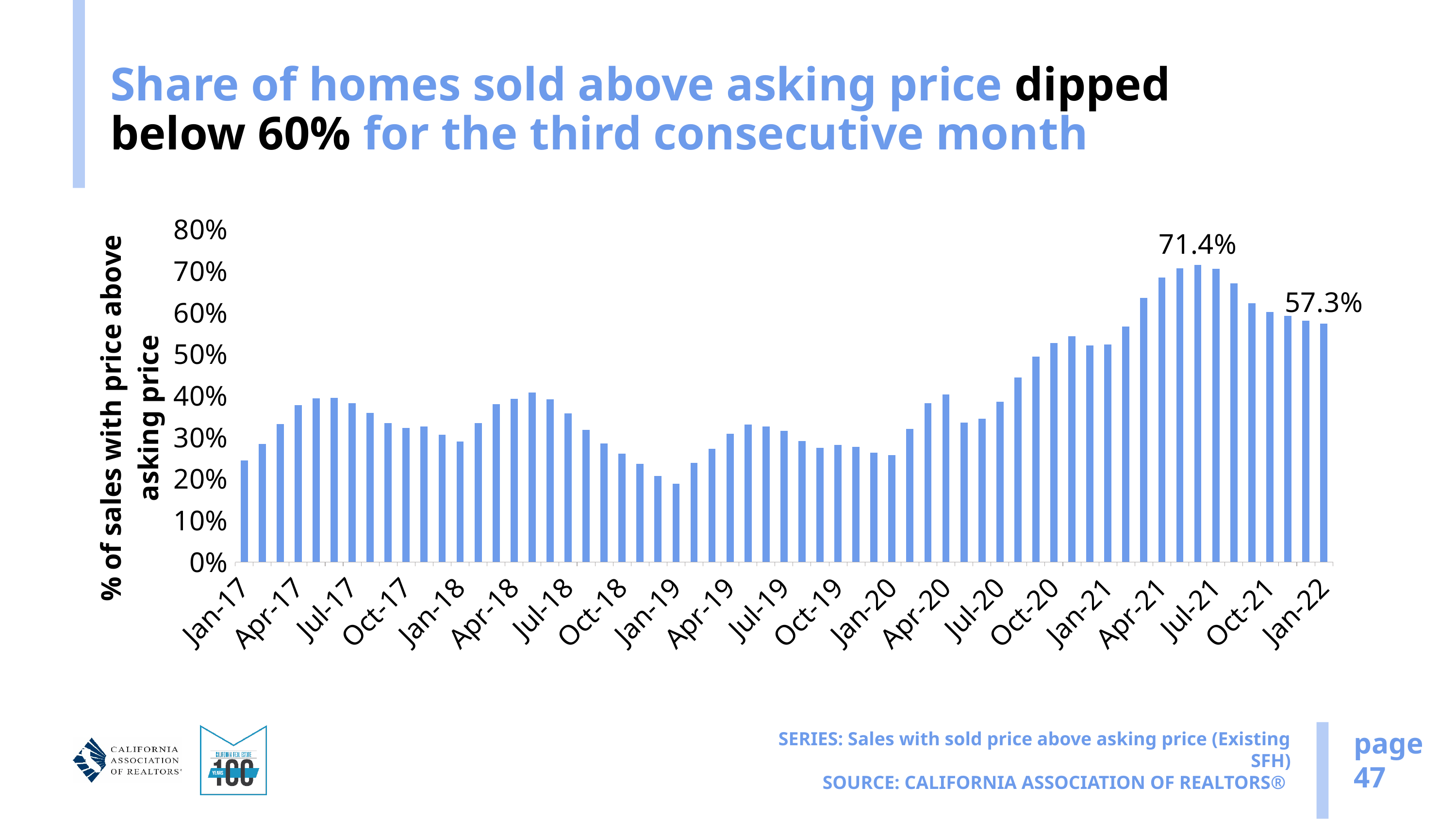
Do the values rise or fall from the 71.4% peak to Jan-22? fall Is the value for Jan-17 greater or less than 30%? less Do the values rise or fall from Jan-20 to the peak in mid-2021? rise What is the title of the vertical axis? % of sales with price above asking price What is the share of sales with price above asking price for Jan-22? 57.3% What type of chart is shown on the slide? Bar chart What is the difference between the peak value of 71.4% and the Jan-22 value of 57.3%? 14.1 percentage points Is the value for Oct-20 greater or less than 50%? greater Which month has the larger value, Jan-17 or Jan-22? Jan-22 What is the value of the tallest bar in the chart? 71.4% Is the value for Jan-20 greater or less than 30%? less